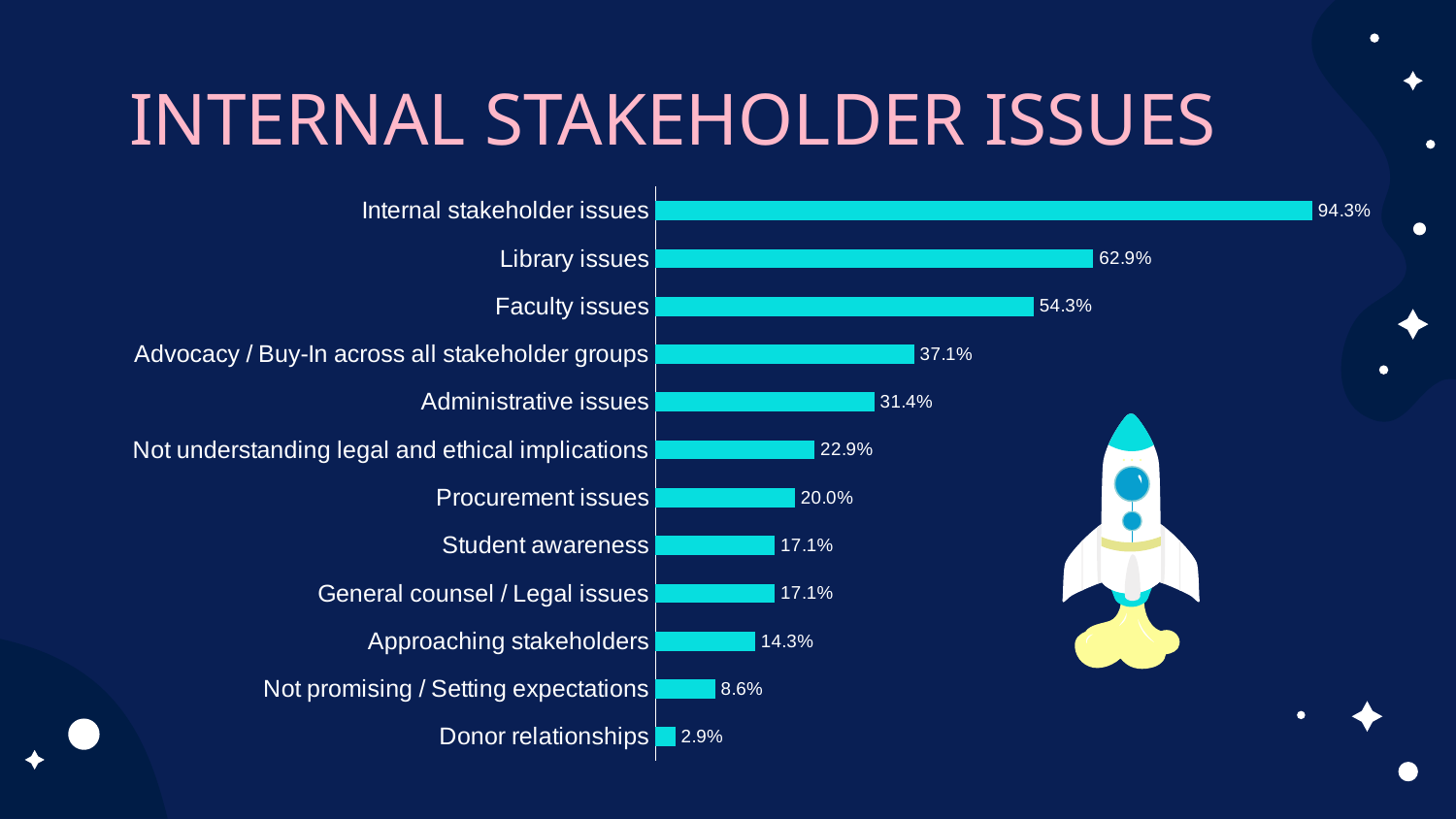
What is the value for Not promising / Setting expectations? 8.6% What is the difference between the values for Faculty issues and Administrative issues? 22.9% How many categories are shown in the chart? 12 What is the value for Advocacy / Buy-In across all stakeholder groups? 37.1% What is the difference between the values for Internal stakeholder issues and Library issues? 31.4% What is the title of the slide? INTERNAL STAKEHOLDER ISSUES Which category has the lowest value? Donor relationships Which is larger, the value for Procurement issues or the value for Not understanding legal and ethical implications? Not understanding legal and ethical implications What is the value for Approaching stakeholders? 14.3% What is the value for Library issues? 62.9% Which category has the highest value? Internal stakeholder issues What kind of chart is shown on the slide? Bar chart